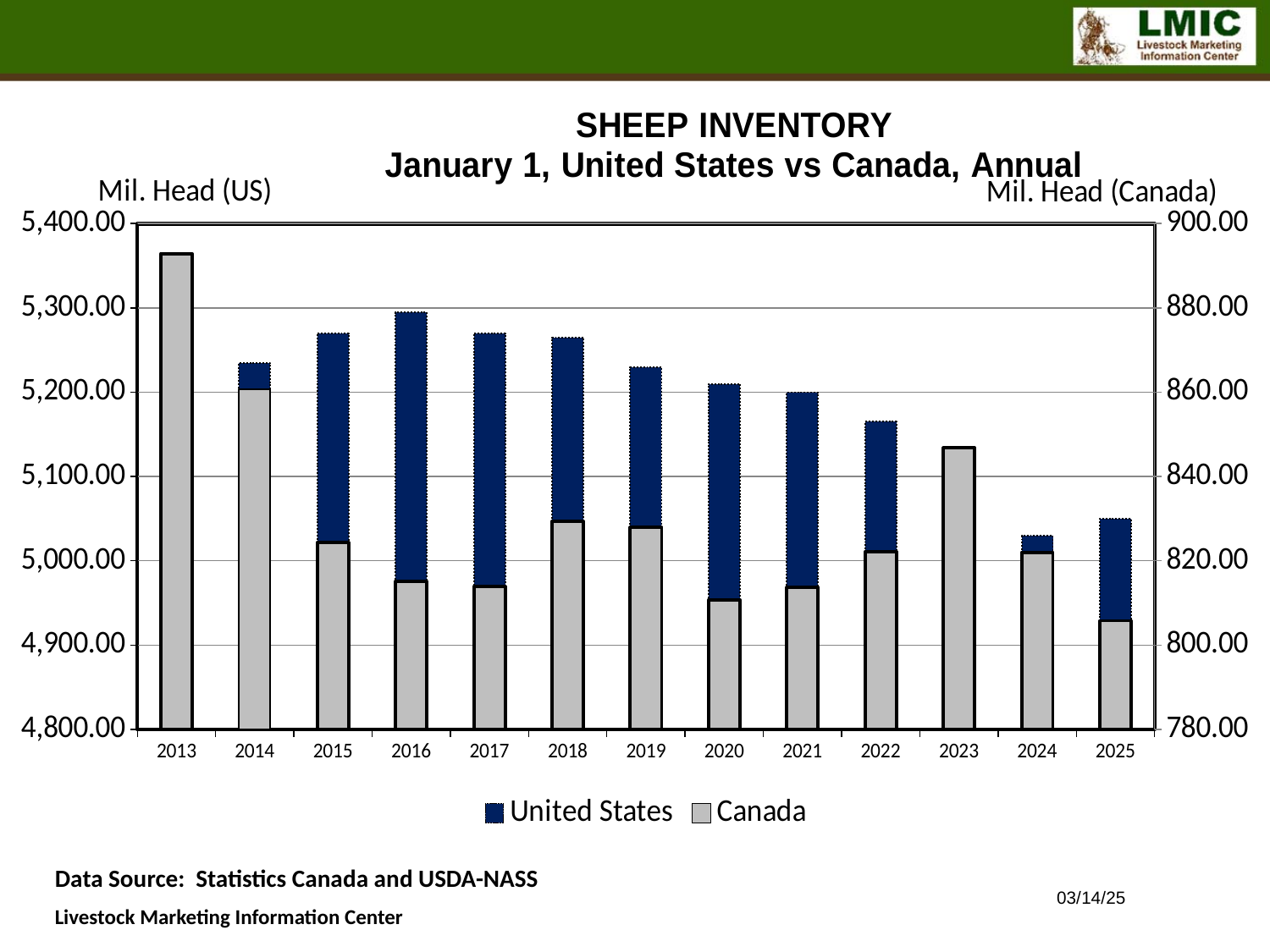
What kind of chart is shown on the slide? bar chart How many series does the legend list? 2 In which year is the Canada bar the tallest? 2013 Which series is plotted in grey? Canada What is the label of the right-hand vertical axis? Mil. Head (Canada) Do the United States values rise or fall from 2016 to 2025? fall Is the United States value for 2016 greater or less than 5,200.00 on the left axis? greater Is the United States value for 2025 greater or less than 5,100.00 on the left axis? less How many years are shown on the x axis? 13 Is the Canada value for 2023 greater or less than 840.00 on the right axis? greater Which is larger, the United States value for 2016 or for 2021? 2016